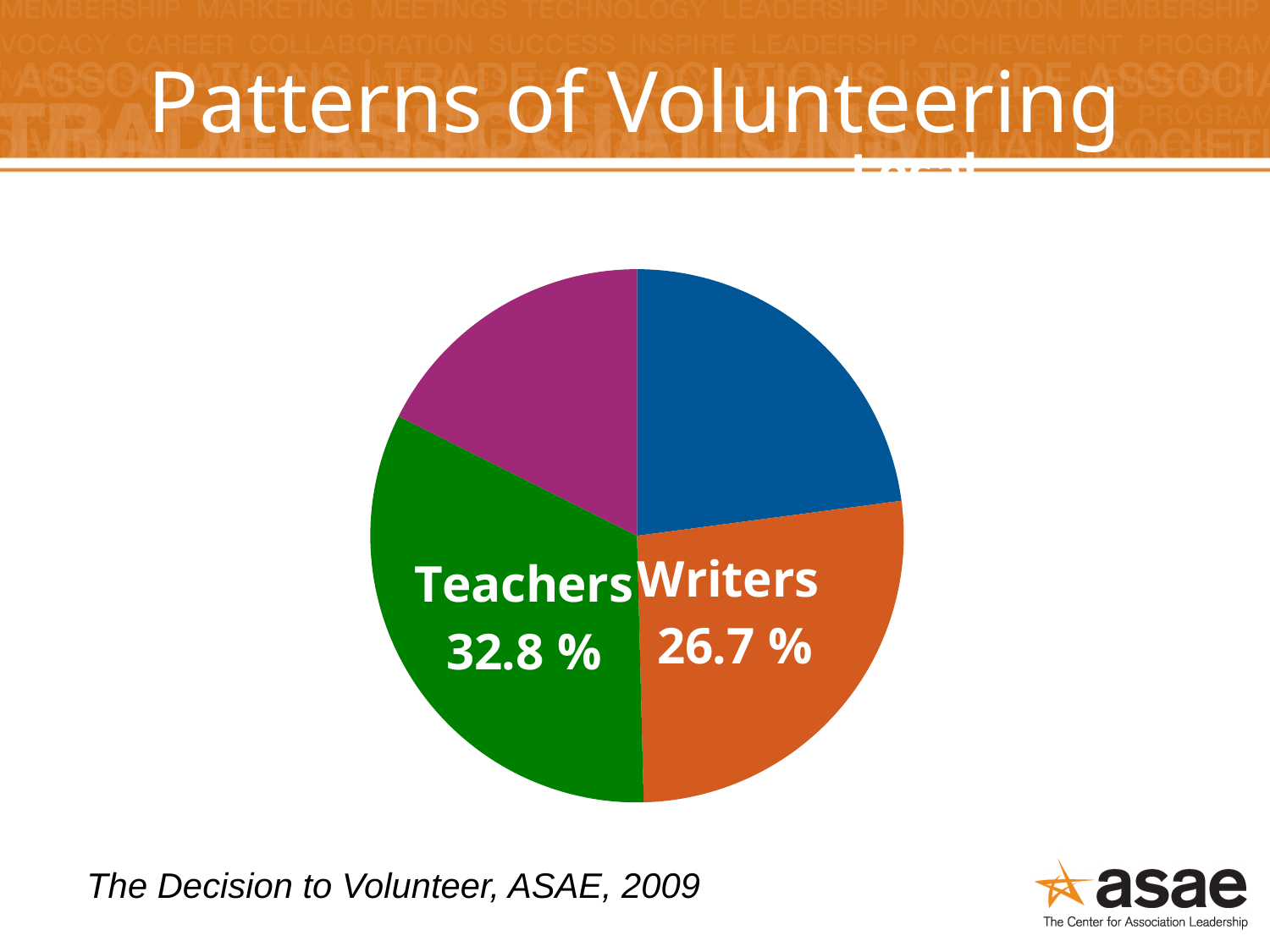
What kind of chart is shown on the slide? pie chart What percentage of the pie is labelled for Teachers? 32.8 % What colour is the Teachers slice of the pie chart? green What is the difference between the Teachers share and the Writers share? 6.1 % What percentage of the pie is labelled for Writers? 26.7 % How many slices does the pie chart have? 4 Which labelled slice is the largest in the pie chart? Teachers What is the title of the slide containing the pie chart? Patterns of Volunteering Which slice is larger, Teachers or Writers? Teachers